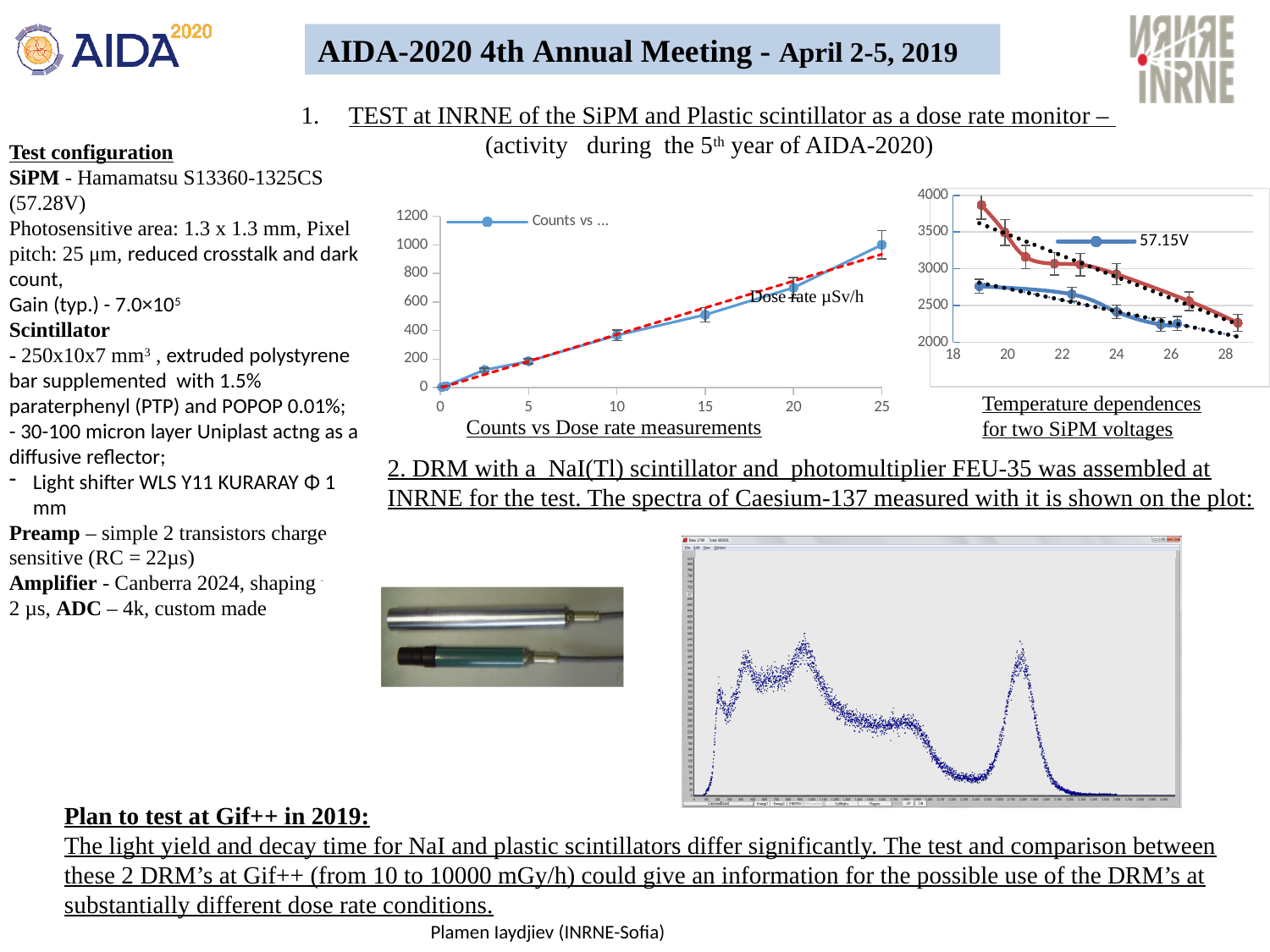
In the 'Counts vs Dose rate measurements' chart, at which dose rate value on the x axis is the count highest? 25 What kind of chart is the 'Counts vs Dose rate measurements' chart? line chart What voltage is listed in the legend of the 'Temperature dependences for two SiPM voltages' chart? 57.15V In the 'Temperature dependences for two SiPM voltages' chart, is the value of the blue series at a temperature of 19 greater or less than 3000? less In the 'Counts vs Dose rate measurements' chart, is the count at a dose rate of 15 greater or less than 600? less In the 'Counts vs Dose rate measurements' chart, is the count at a dose rate of 5 greater or less than 400? less What is the highest tick value shown on the y axis of the 'Counts vs Dose rate measurements' chart? 1200 In the 'Counts vs Dose rate measurements' chart, do the counts rise or fall as the dose rate increases along the x axis? rise In the 'Temperature dependences for two SiPM voltages' chart, do the values rise or fall as temperature increases along the x axis? fall